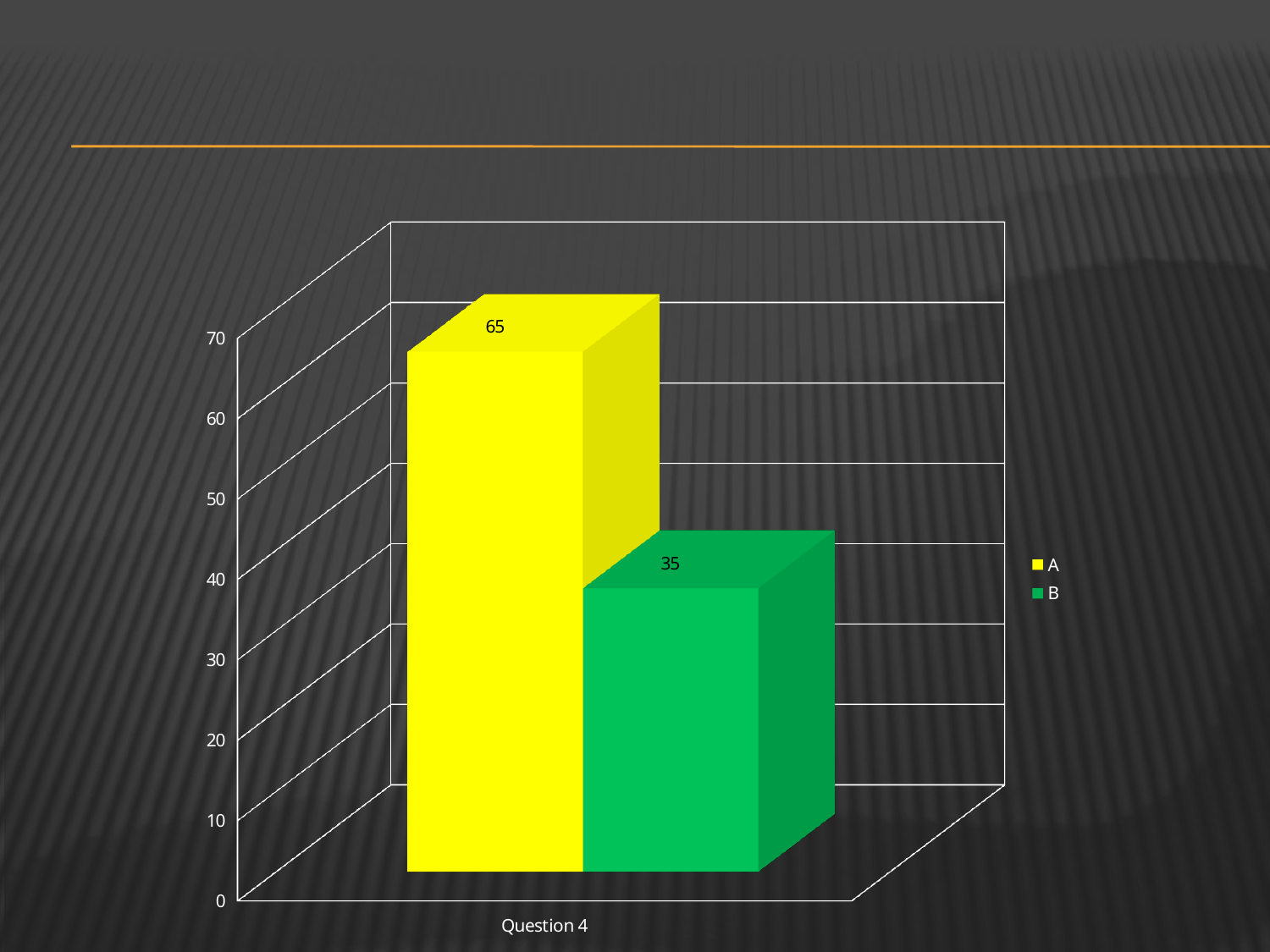
What is the category label shown on the x axis? Question 4 What colour is the bar for series B? green Which series has the higher value, A or B? A How many series does the legend list? 2 What is the difference between the values for A and B? 30 Is the value for B greater or less than 50? less Is the value for A larger or smaller than the value for B? larger Which series has the lower value, A or B? B What is the value for series B in the Question 4 chart? 35 What is the value for series A in the Question 4 chart? 65 Is the value for A greater or less than 60? greater What kind of chart is shown on the slide? bar chart